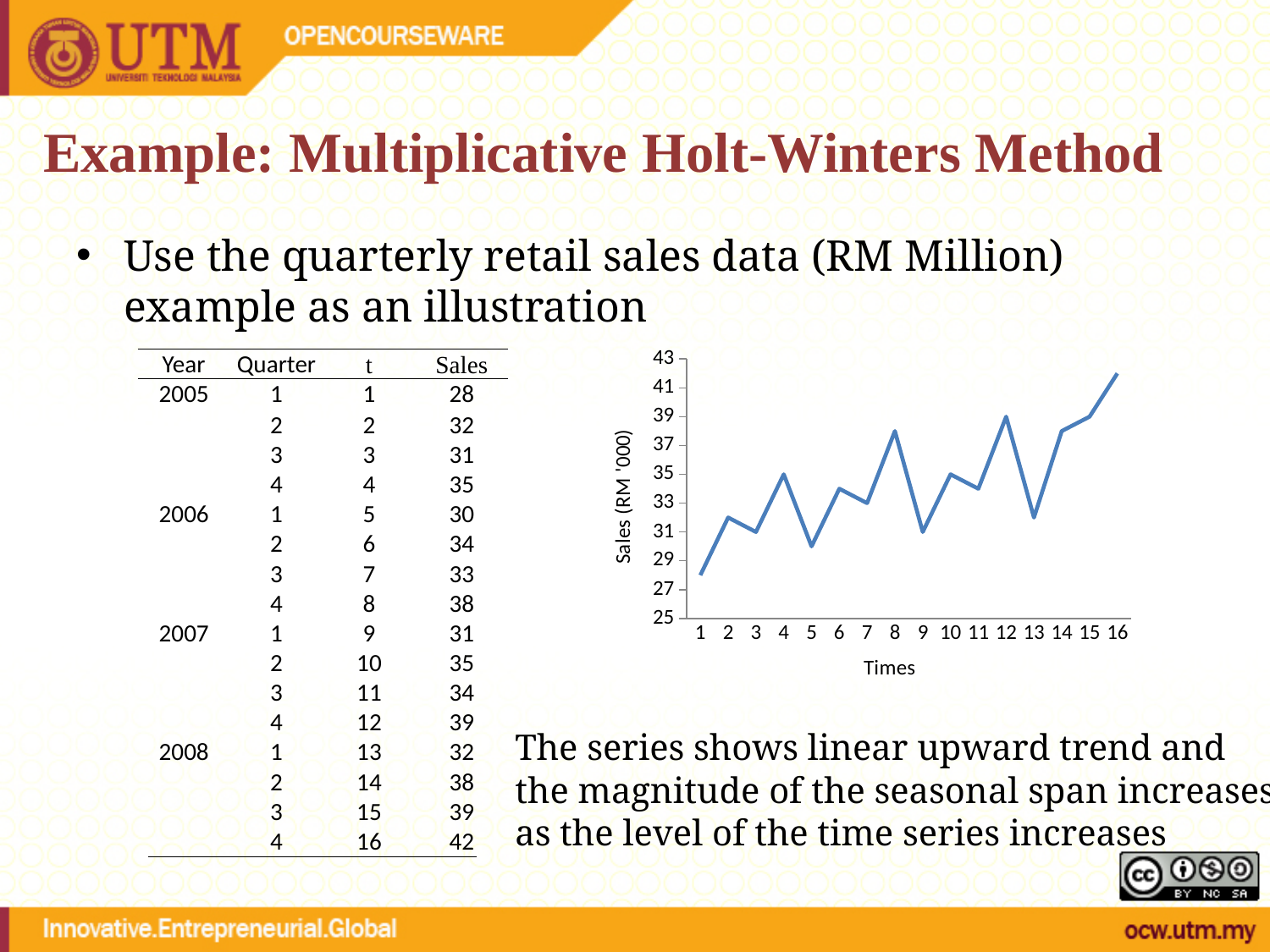
What is the sales value at time 4 in the line chart? 35 Overall, do the sales values rise or fall as time increases along the x axis? Rise Is the sales value at time 5 greater or less than 31? less How many time points are plotted on the x axis of the line chart? 16 What is the difference between the sales value at time 16 and the sales value at time 1? 14 Which has the higher sales value in the line chart, time 13 or time 14? Time 14 At which time point does the line chart reach its highest sales value? 16 What is the sales value at time 12 in the line chart? 39 What kind of chart is shown on the slide? Line chart Is the sales value at time 8 greater or less than 37? greater At which time point does the line chart show its lowest sales value? 1 What is the sales value at time 16 in the line chart? 42